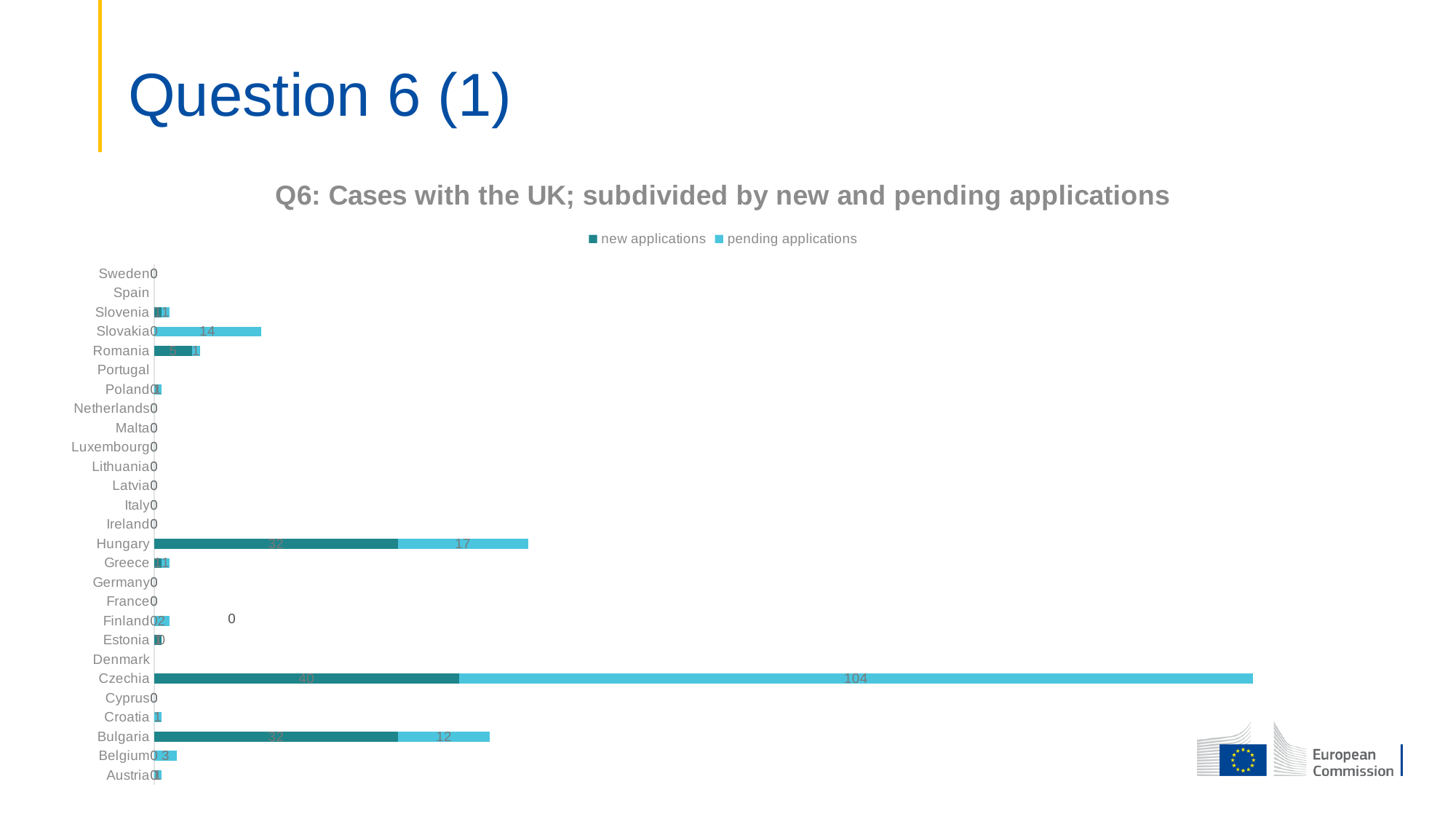
Which country has the highest number of pending applications? Czechia What is the total number of cases (new plus pending) for Hungary? 49 How many new applications are shown for Hungary? 32 What kind of chart is shown on the slide? Bar chart How many new applications are shown for Romania? 5 How many countries are listed on the chart's axis? 27 What is the total number of cases (new plus pending) for Czechia? 144 How many pending applications are shown for Czechia? 104 How many pending applications are shown for Slovakia? 14 Which has more pending applications, Hungary or Bulgaria? Hungary What is the difference between pending and new applications for Czechia? 64 How many series does the legend list? 2